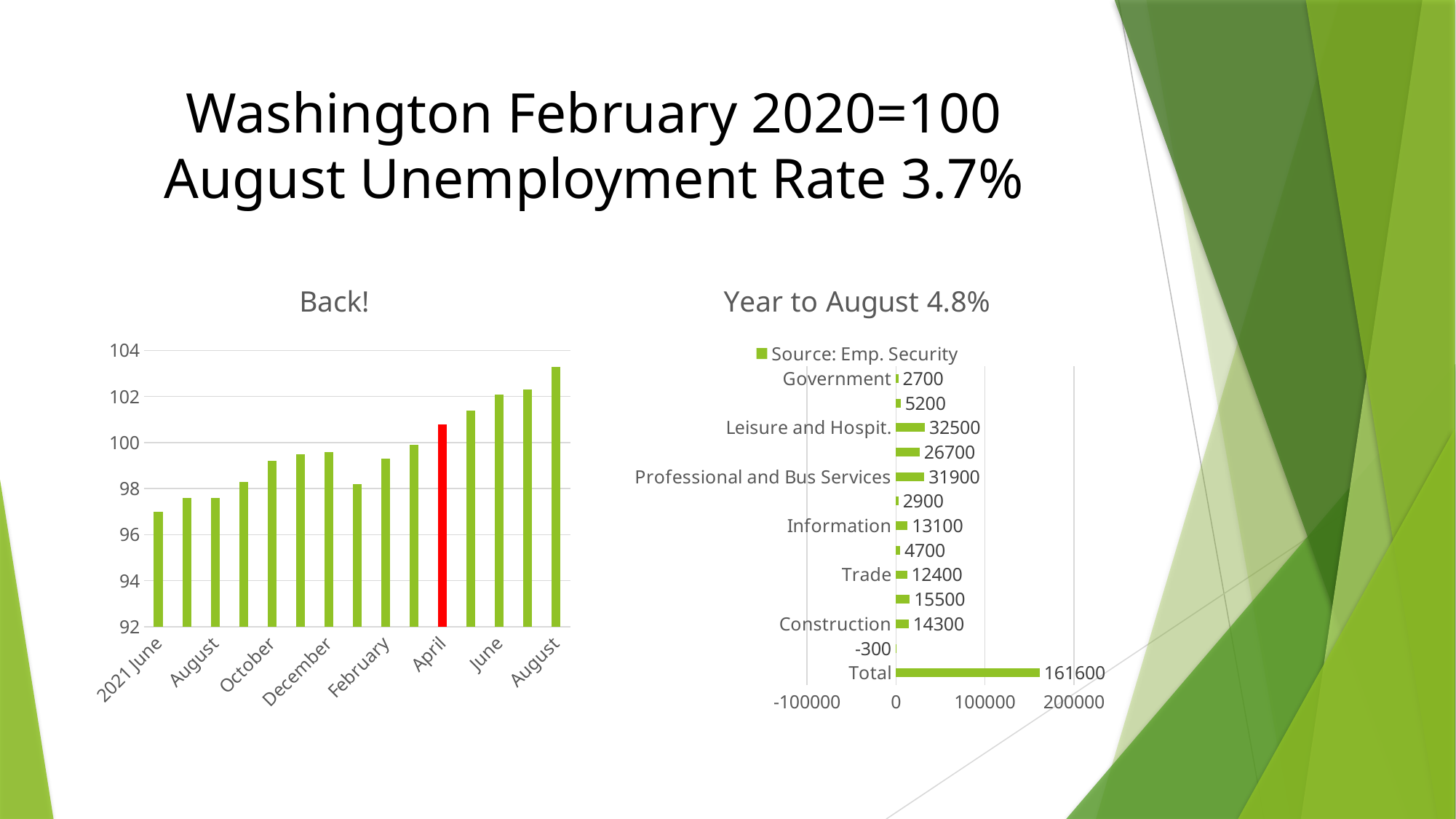
In the 'Year to August 4.8%' chart, what is the value for Construction? 14300 In the 'Back!' chart, which month's bar is coloured red? April In the 'Back!' chart, is the value for 2021 June greater or less than 98? less In the 'Year to August 4.8%' chart, what is the value for Total? 161600 In the 'Back!' chart, do the values generally rise or fall from 2021 June to August? rise In the 'Year to August 4.8%' chart, what is the value for Leisure and Hospit.? 32500 In the 'Year to August 4.8%' chart, which is larger, Trade or Construction? Construction In the 'Year to August 4.8%' chart, what is the difference between Leisure and Hospit. and Professional and Bus Services? 600 In the 'Back!' chart, which month has the highest value? August (the last bar) In the 'Year to August 4.8%' chart, what is the value for Information? 13100 What kind of chart is the 'Back!' chart? bar chart In the 'Year to August 4.8%' chart, what entry does the legend show? Source: Emp. Security